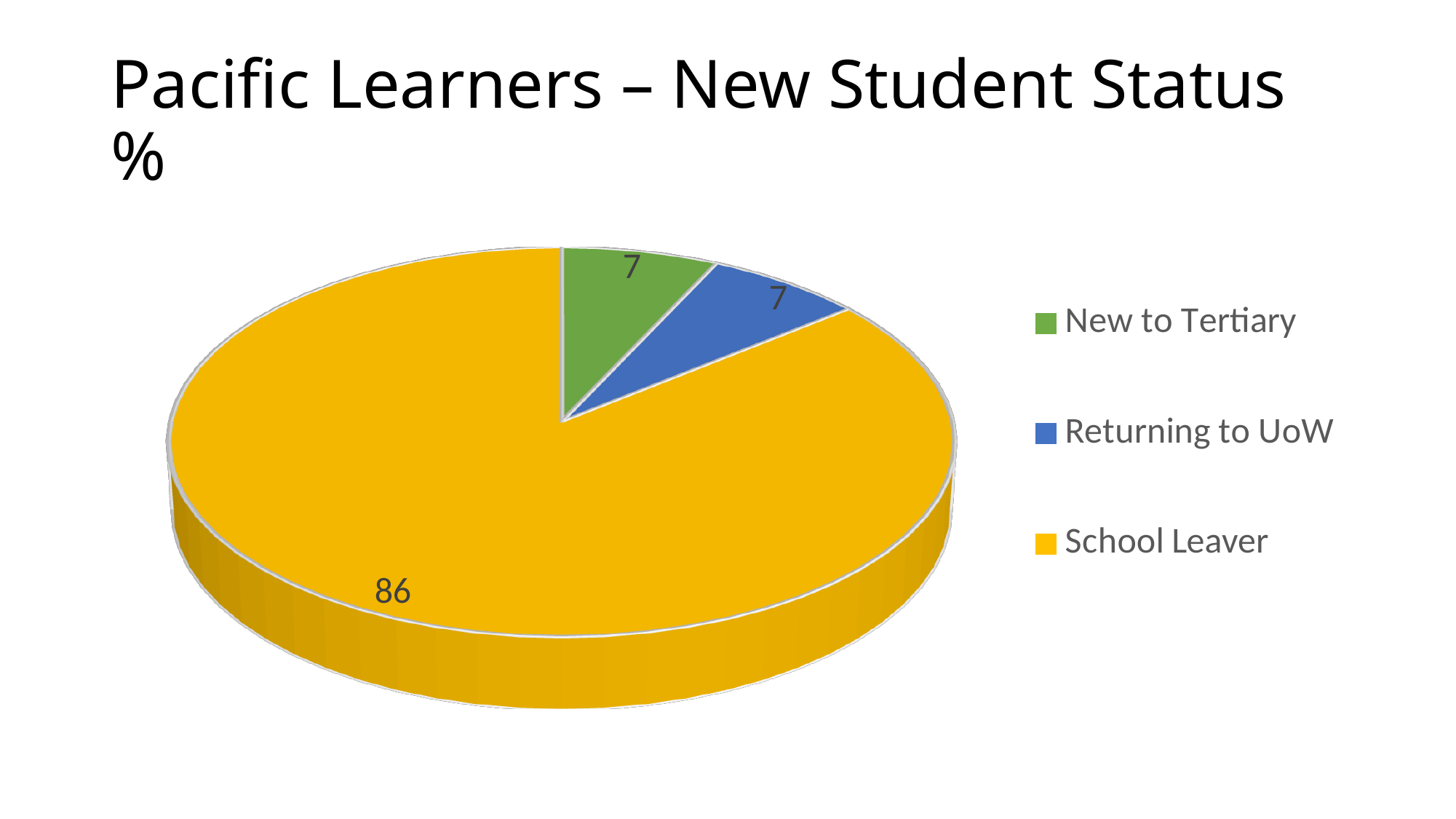
What is the total of the three slice values? 100 What is the value for New to Tertiary? 7 Which category has the largest slice? School Leaver What is the difference between the School Leaver value and the New to Tertiary value? 79 What kind of chart is shown on the slide? Pie chart How many categories does the legend list? 3 What is the title of the slide? Pacific Learners – New Student Status % What is the value for School Leaver? 86 What is the value for Returning to UoW? 7 What colour is the School Leaver slice? Yellow Which is larger, School Leaver or Returning to UoW? School Leaver